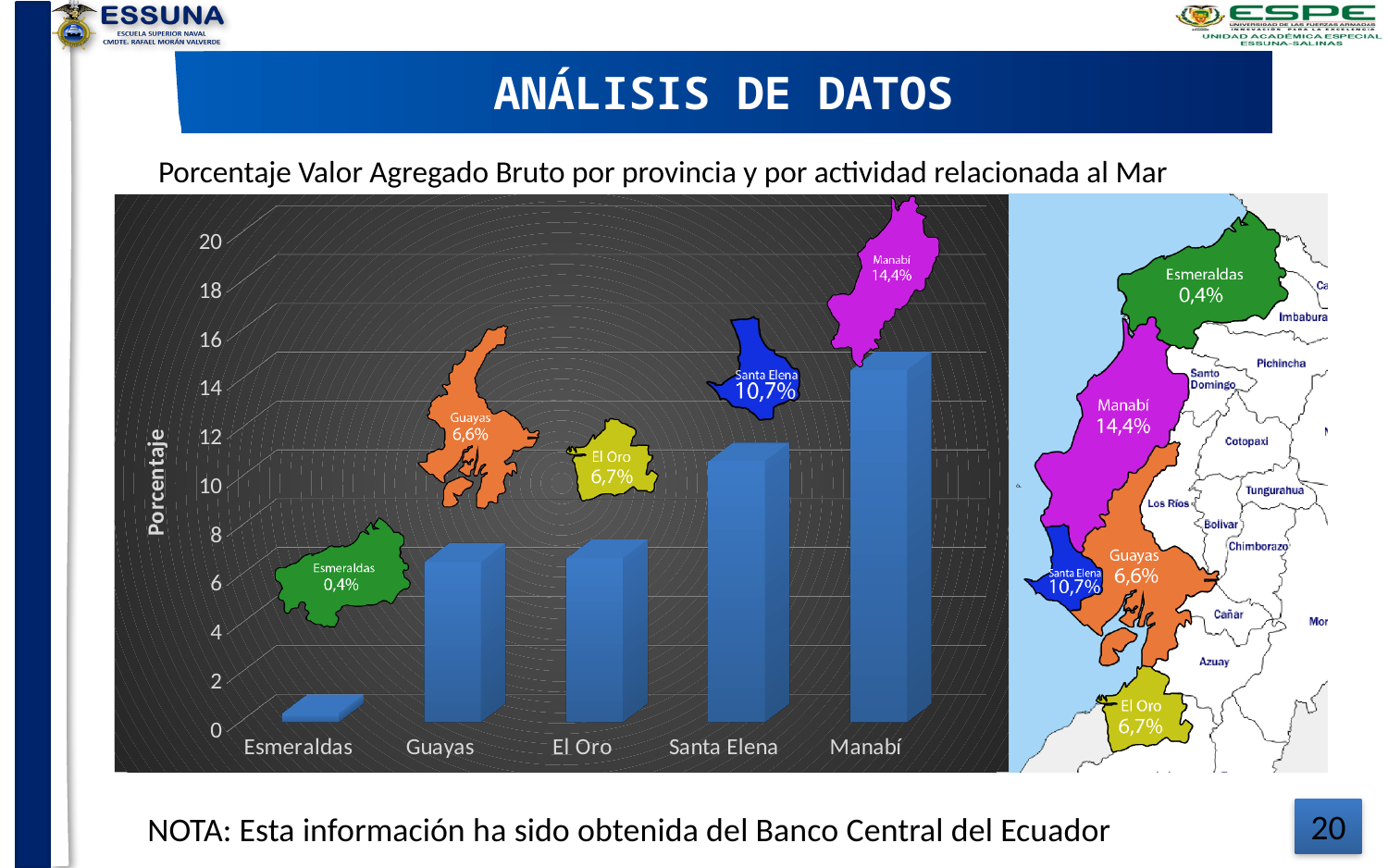
What is the label of the vertical axis of the chart? Porcentaje Which province has the lowest value in the chart? Esmeraldas Is the value for El Oro greater or less than 10? less What is the percentage value for Guayas? 6,6% What is the percentage value for Manabí? 14,4% What is the percentage value for Esmeraldas? 0,4% What is the percentage value for Santa Elena? 10,7% Which has a larger value, Santa Elena or Guayas? Santa Elena Which province has the highest value in the chart? Manabí What type of chart is shown on the slide? Bar chart What is the difference between the values for Manabí and Santa Elena? 3,7% How many provinces are shown on the x axis of the chart? 5